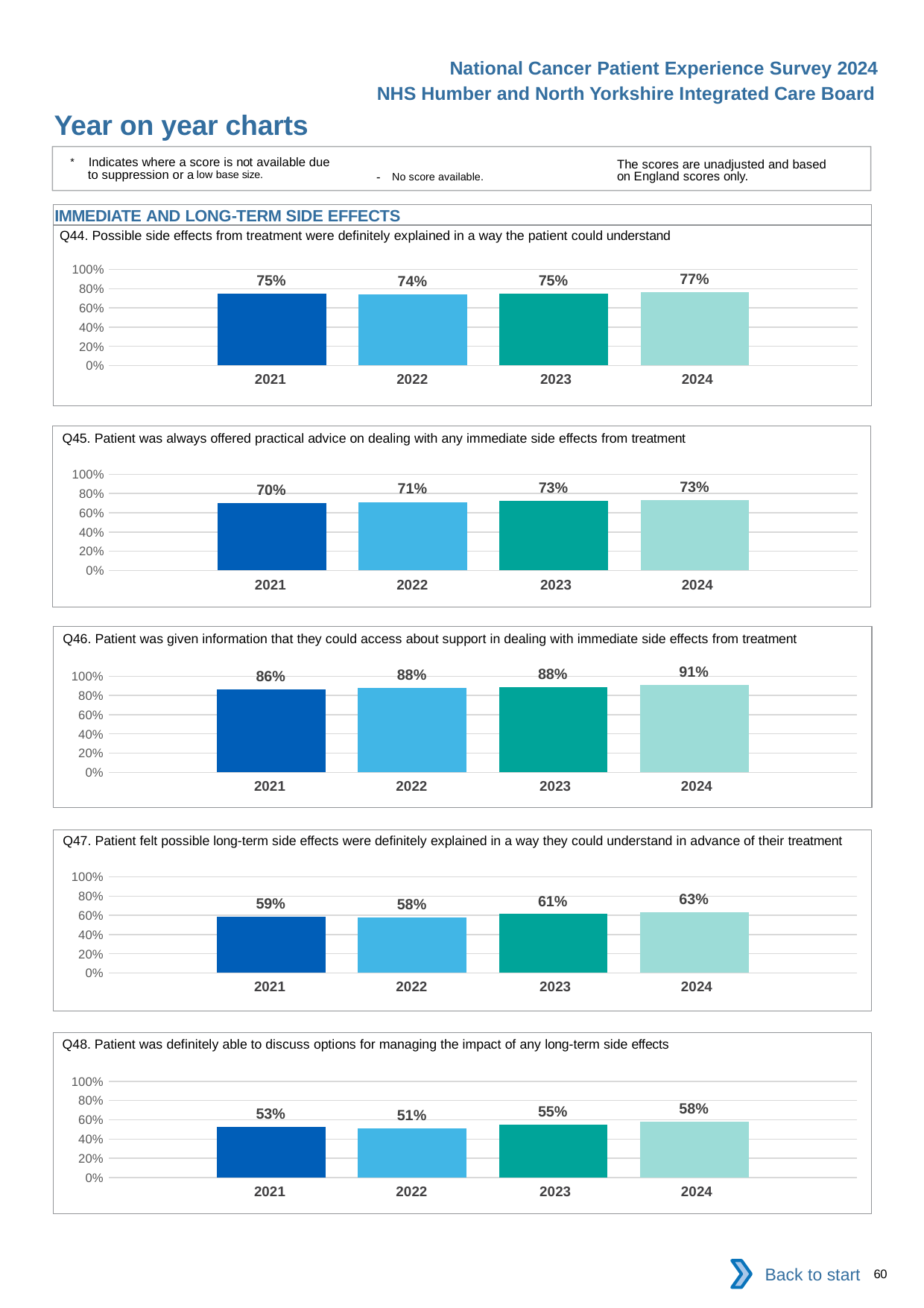
In the Q47 chart, what is the difference between the 2023 value and the 2022 value? 3% What kind of chart is the Q47 chart? bar chart In the Q46 chart, which year has the highest value? 2024 In the Q44 chart, what is the value for 2024? 77% In the Q48 chart, is the value for 2022 greater or less than 60%? less In the Q46 chart, which is larger, the value for 2021 or the value for 2024? 2024 In the Q48 chart, what is the difference between the 2024 value and the 2021 value? 5% In the Q47 chart, which year has the lowest value? 2022 In the Q45 chart, what is the value for 2021? 70% In the Q45 chart, do the values generally rise or fall from 2021 to 2024? rise How many years are shown in the Q44 chart? 4 What is the section heading above the Q44 chart? IMMEDIATE AND LONG-TERM SIDE EFFECTS